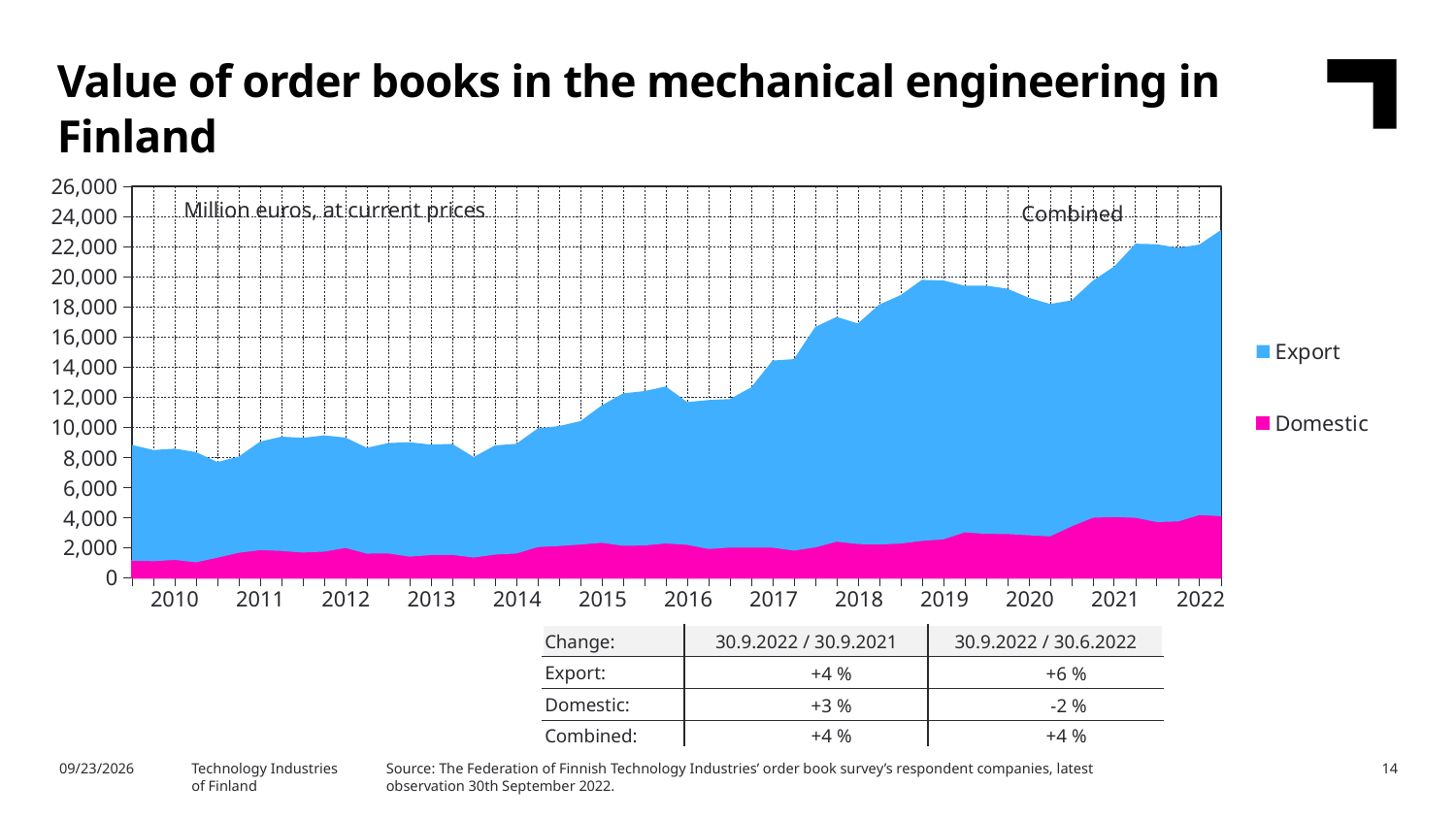
Is the Domestic value at the end of 2022 greater or less than 2,000? greater Does the combined value of order books generally rise or fall from 2010 to 2022? Rise How many series does the legend list? 2 Is the combined value of order books in 2016 greater or less than 14,000? less Which two series are listed in the chart legend? Export and Domestic In 2022, which series is larger, Export or Domestic? Export Is the combined value of order books at the end of 2022 greater or less than 20,000? greater How many years are labelled on the x axis? 13 In which year does the combined value of order books reach its highest level? 2022 What unit is stated in the chart's subtitle? Million euros, at current prices What kind of chart is shown on the slide? Area chart